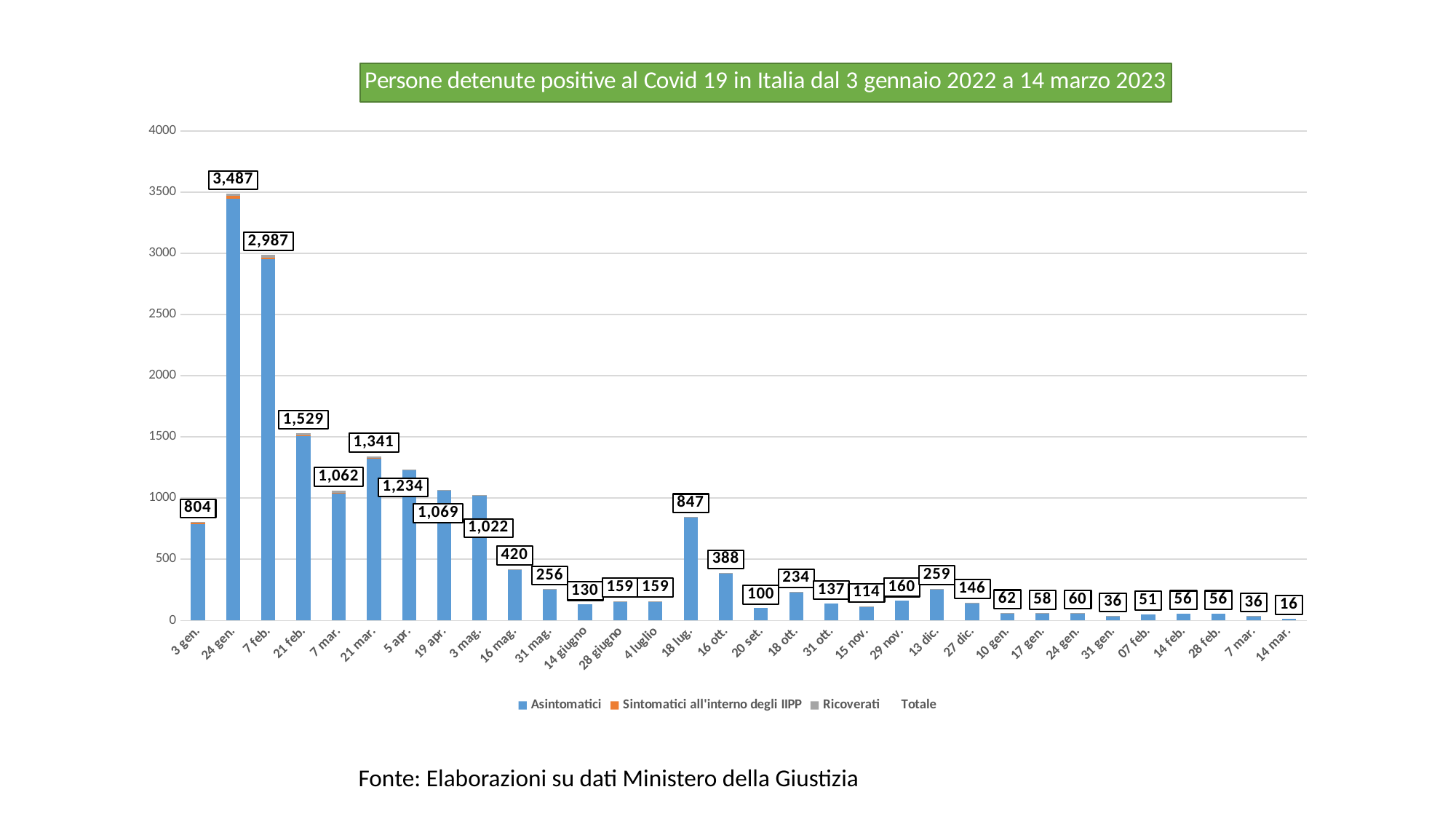
What is the total value shown for 14 mar.? 16 Which date has the lowest total of positive detainees? 14 mar. How many dates are shown on the x axis? 32 Is the value for 21 mar. greater or less than 1000? greater What is the difference between the totals for 24 gen. and 7 feb.? 500 Do the totals rise or fall from 24 gen. to 3 mag.? Fall What kind of chart is shown on the slide? Bar chart What is the total value shown for 18 lug.? 847 Which date has the highest total of positive detainees? 24 gen. How many series does the legend list? 4 Which is larger, the total for 18 lug. or the total for 16 ott.? 18 lug.